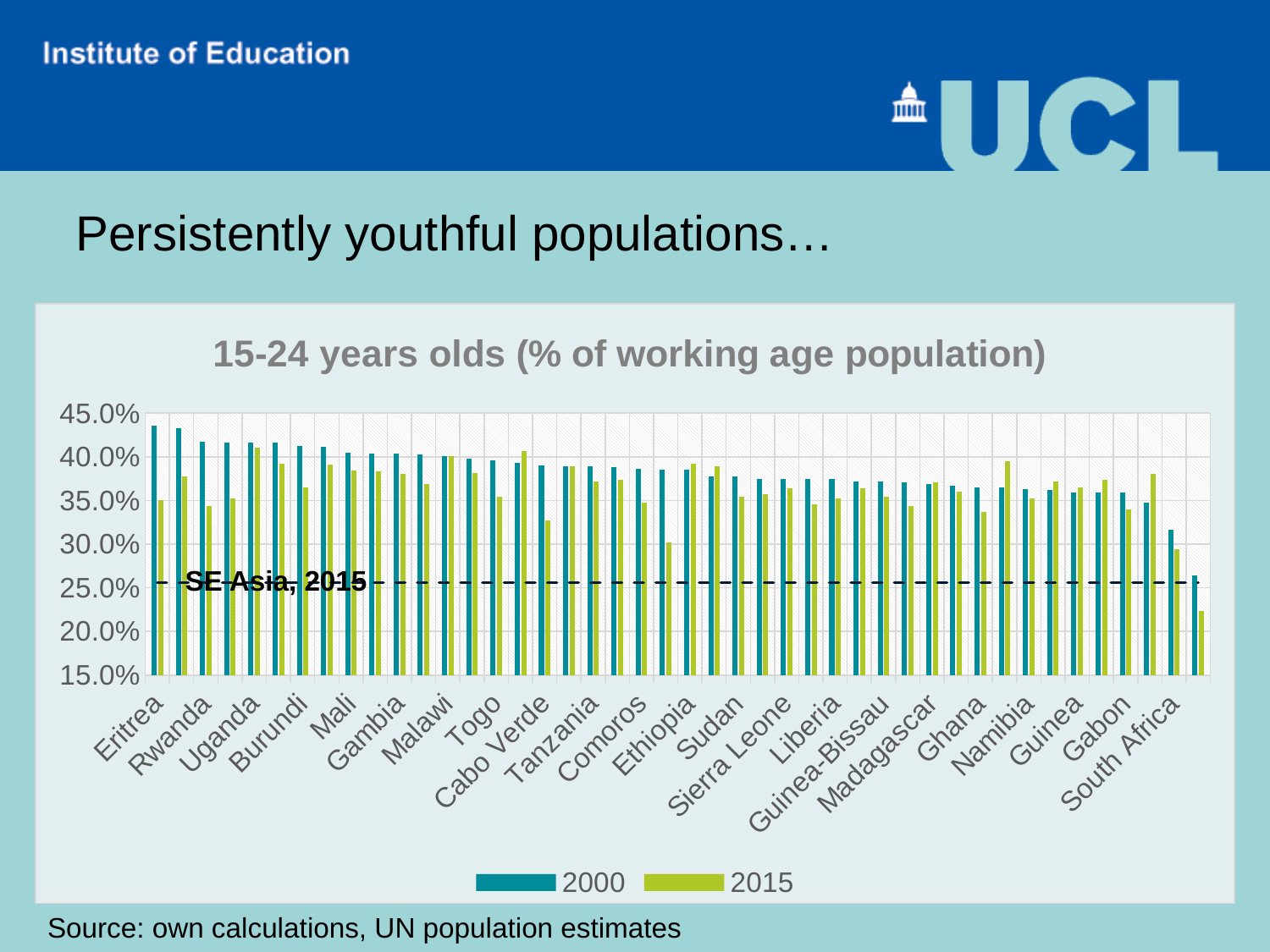
How many series does the legend list? 2 What is the title of the chart? 15-24 years olds (% of working age population) What does the dashed horizontal line across the chart represent? SE Asia, 2015 Do the 2000 values generally rise or fall from left to right across the countries? fall Which country has the larger 2000 value, Eritrea or South Africa? Eritrea Which is larger for Eritrea, the 2000 value or the 2015 value? 2000 What kind of chart is shown on the slide? bar chart Which country has the highest value for 2000? Eritrea Is the 2000 value for Eritrea greater or less than 40.0%? greater Which two years are shown in the legend? 2000 and 2015 Is the 2015 value for South Africa greater or less than 25.0%? greater